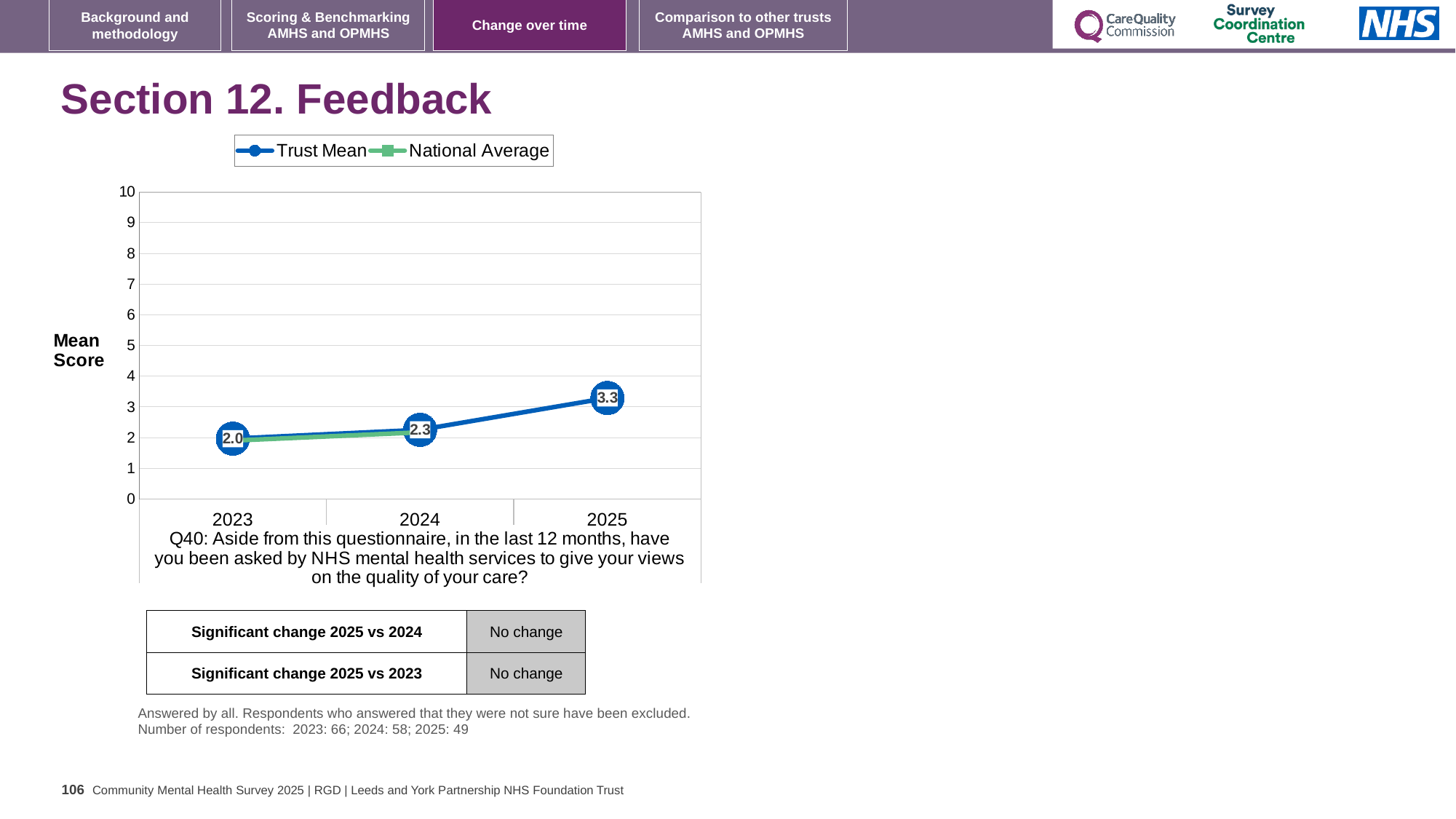
Is the Trust Mean for 2025 greater or less than 4? less What is the difference between the Trust Mean in 2025 and in 2024? 1.0 In which year is the Trust Mean lowest? 2023 What is the Trust Mean value for 2024? 2.3 What is the difference between the Trust Mean in 2025 and in 2023? 1.3 What kind of chart is shown on the slide? line chart What is the Trust Mean value for 2025? 3.3 What is the Trust Mean value for 2023? 2.0 In which year is the Trust Mean highest? 2025 How many years are shown on the x axis? 3 How many series does the legend list? 2 Which is larger, the Trust Mean for 2024 or for 2025? 2025